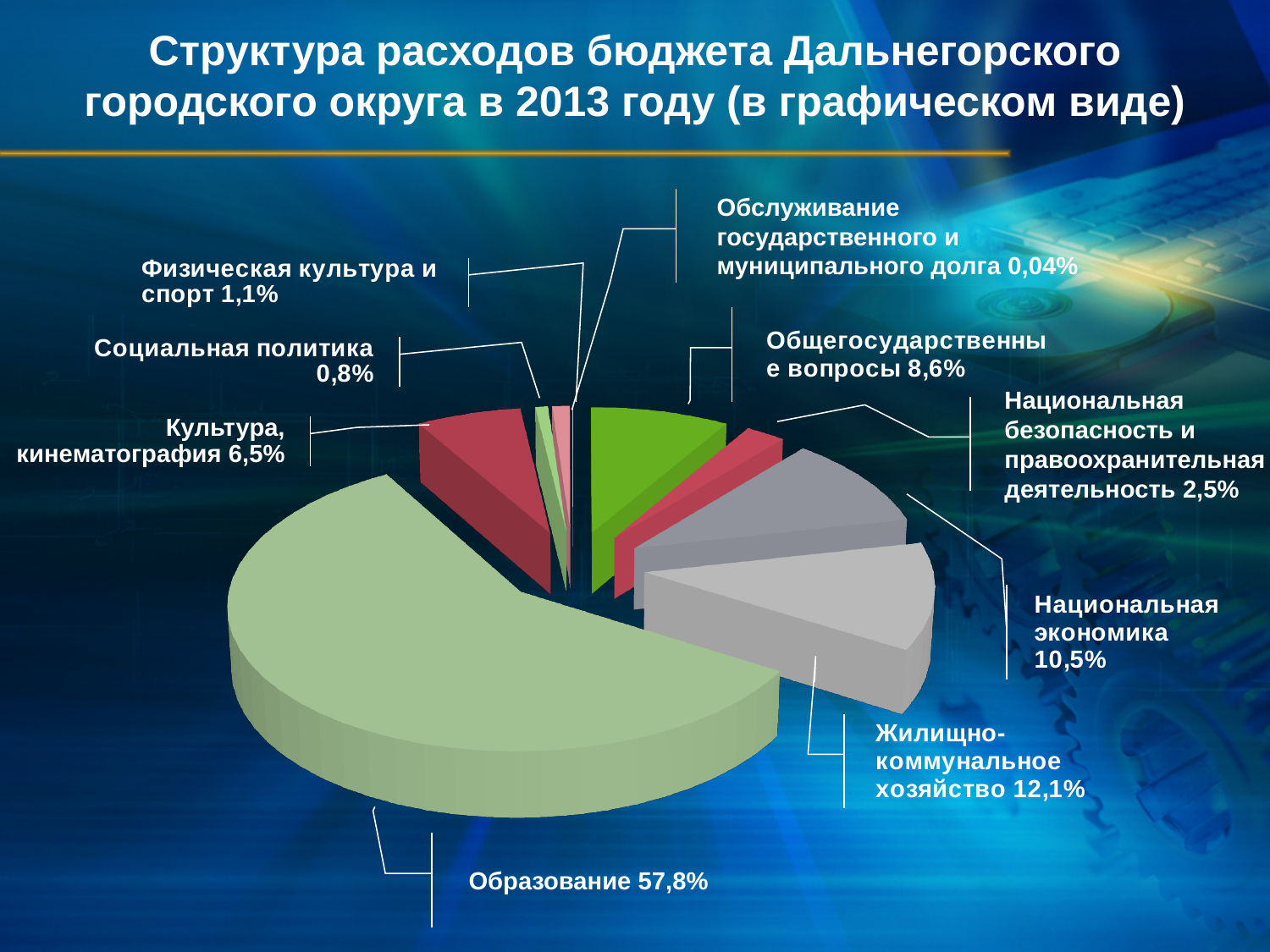
What is the difference in percentage points between Жилищно-коммунальное хозяйство and Национальная экономика? 1,6 Which is larger: Общегосударственные вопросы or Культура, кинематография? Общегосударственные вопросы What is the value shown for Жилищно-коммунальное хозяйство? 12,1% What share of the budget expenditure goes to Образование? 57,8% What percentage is shown for Национальная экономика? 10,5% What is the value for Обслуживание государственного и муниципального долга? 0,04% Which category has the smallest share of the pie? Обслуживание государственного и муниципального долга What is the difference in percentage points between Образование and Жилищно-коммунальное хозяйство? 45,7 What type of chart is shown on the slide? Pie chart How many categories are shown in the pie chart? 9 Which category has the largest share of the pie? Образование What year does the chart title say the budget expenditure structure refers to? 2013